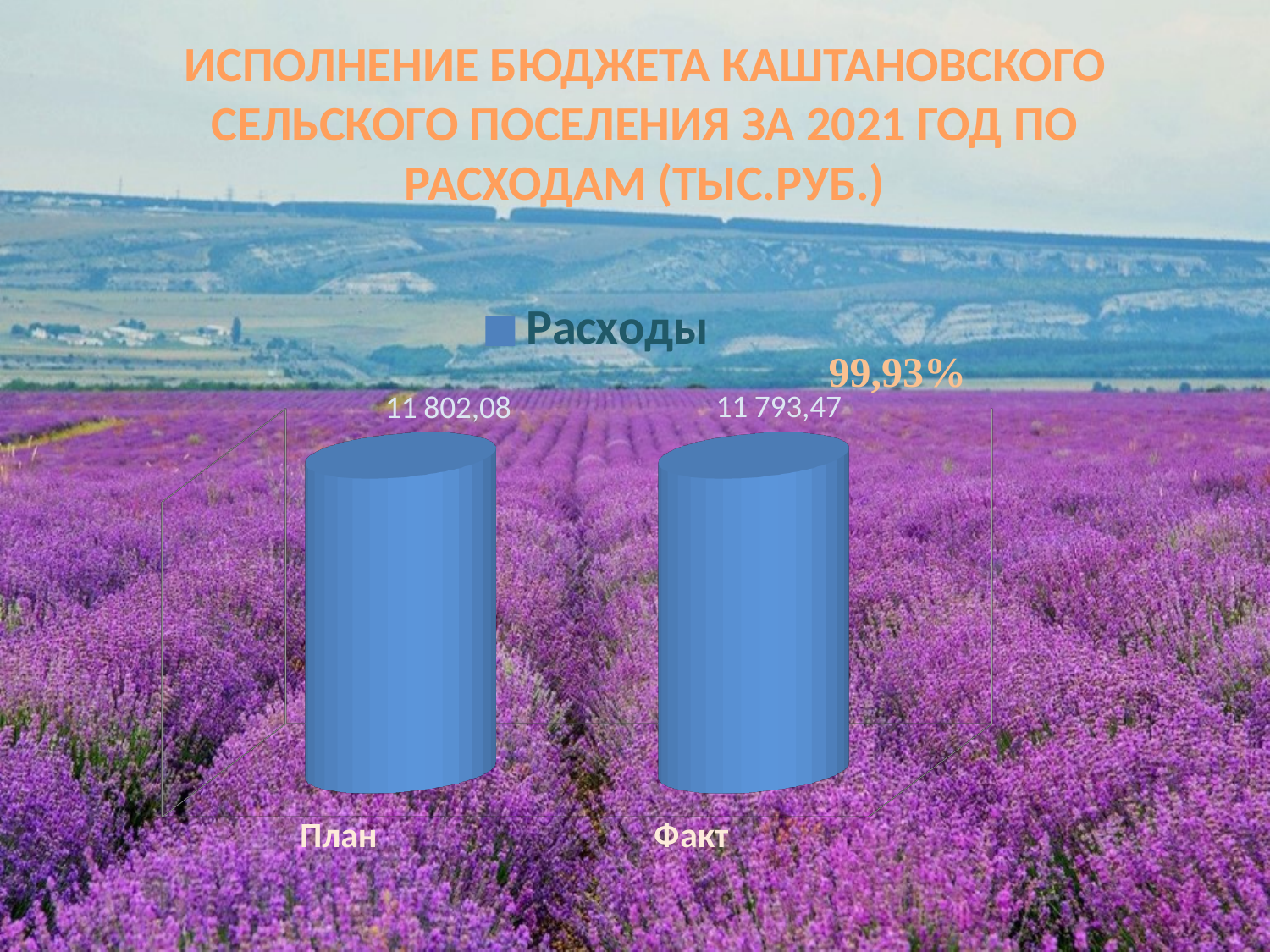
What percentage is printed above the Факт bar? 99,93% What kind of chart is shown on the slide? Bar chart What are the two category labels on the x axis? План, Факт What is the value for План? 11 802,08 How many series does the legend list? 1 How many categories are shown on the chart? 2 Which is larger according to the data labels, План or Факт? План What is the value for Факт? 11 793,47 What series name is shown in the legend? Расходы What is the difference between the План and Факт values? 8,61